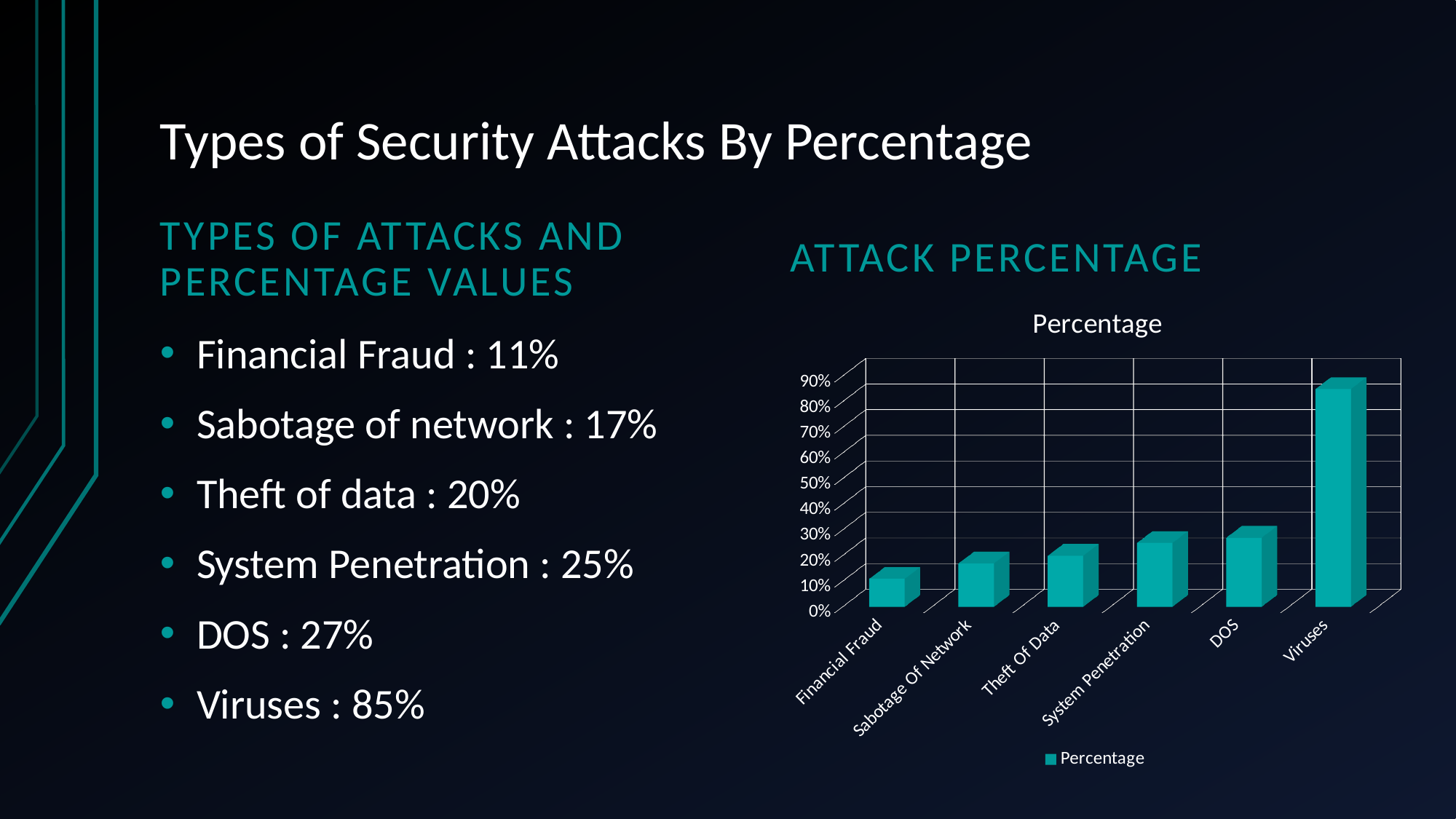
Which category has the lowest bar in the chart? Financial Fraud What is the title of the chart? Percentage Which is larger, the bar for DOS or the bar for Theft Of Data? DOS According to the slide, what is the percentage value for System Penetration? 25% Is the value for Financial Fraud greater or less than 20%? less How many categories are plotted on the x axis of the chart? 6 Is the value for Viruses greater or less than 80%? greater What type of chart is shown on the slide? bar chart Is the value for DOS greater or less than 40%? less Which category has the highest bar in the chart? Viruses Do the bar values rise or fall moving left to right along the x axis? rise How many series does the chart legend list? 1